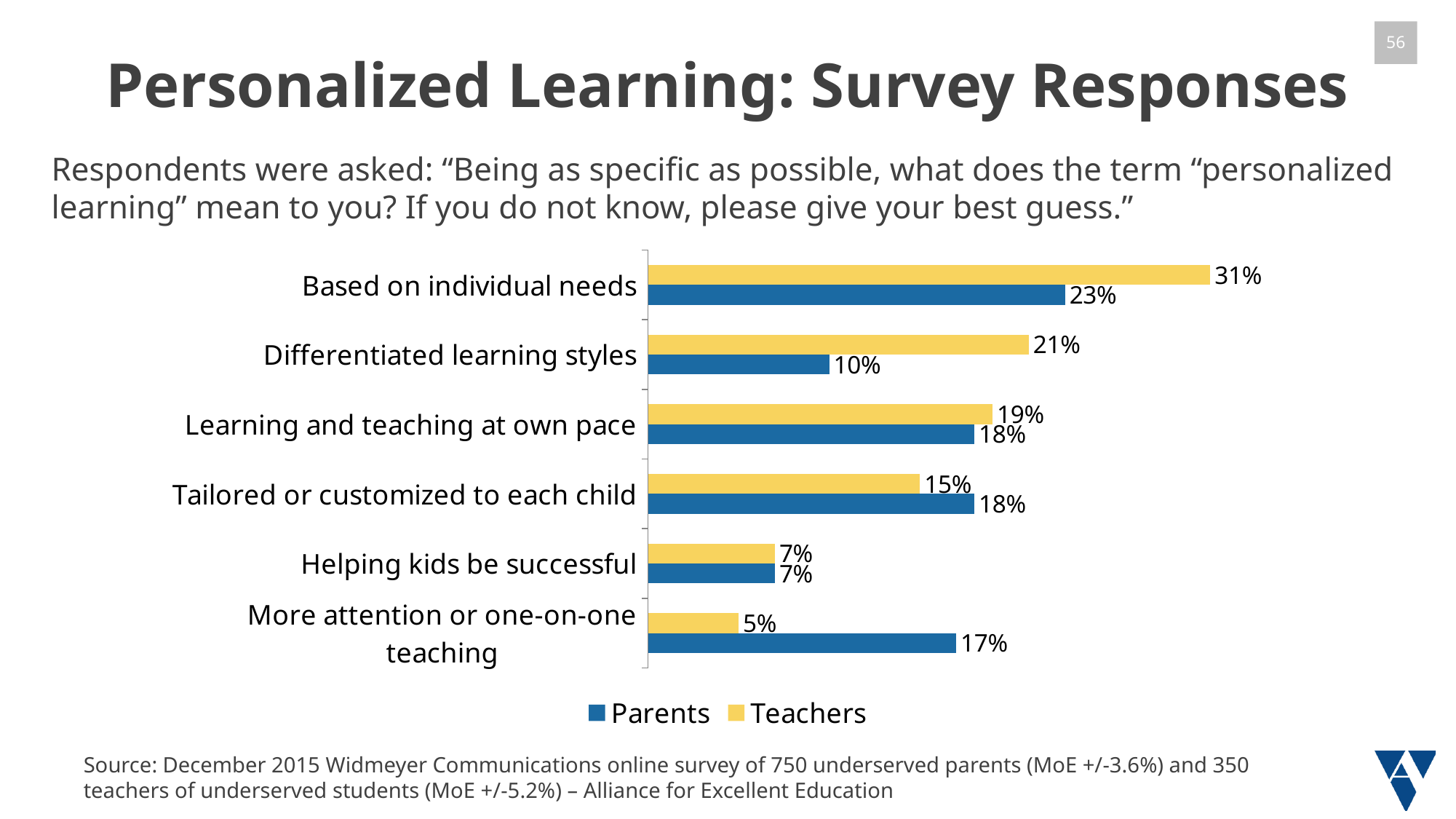
What is the difference between the Teachers and Parents values for "Based on individual needs"? 8% What percentage of Teachers said personalized learning means "Based on individual needs"? 31% What percentage of Parents said "More attention or one-on-one teaching"? 17% What is the difference between the Parents and Teachers values for "More attention or one-on-one teaching"? 12% Which colour represents Teachers in the chart? Yellow For "Tailored or customized to each child", which group has the larger value, Parents or Teachers? Parents How many series does the legend list? 2 Which category has the lowest value for Teachers? More attention or one-on-one teaching What kind of chart is shown on the slide? Bar chart How many response categories are shown in the chart? 6 Which category has the highest value for Teachers? Based on individual needs What percentage of Parents said personalized learning means "Differentiated learning styles"? 10%